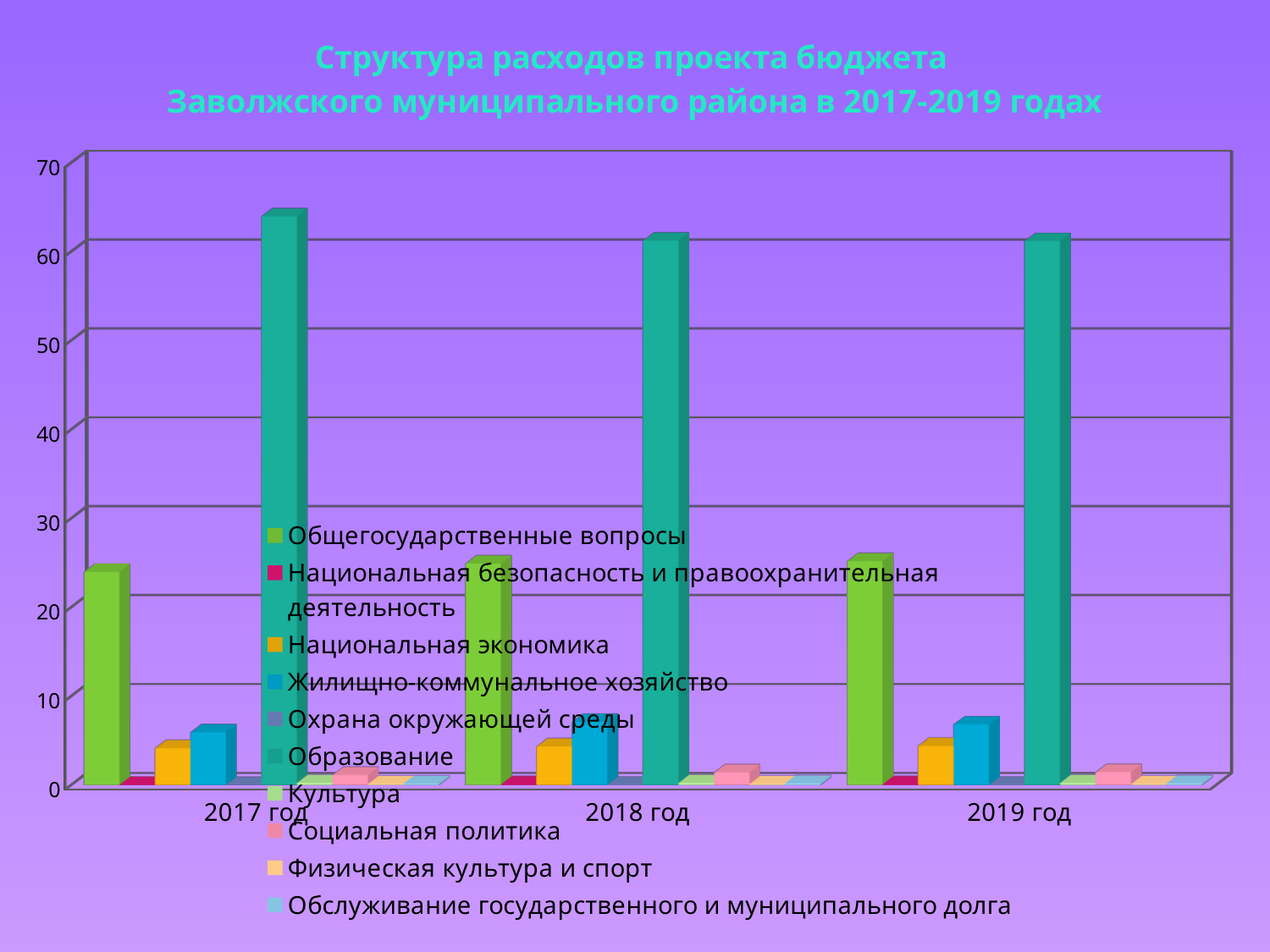
Is the value for Образование in 2017 год greater or less than 50? greater What kind of chart is shown on the slide? bar chart In 2018 год, which is larger: Образование or Общегосударственные вопросы? Образование What is the title of the chart? Структура расходов проекта бюджета Заволжского муниципального района в 2017-2019 годах Is the value for Национальная экономика in 2018 год greater or less than 10? less In 2019 год, which is larger: Жилищно-коммунальное хозяйство or Национальная экономика? Жилищно-коммунальное хозяйство Is the value for Общегосударственные вопросы in 2019 год greater or less than 30? less Which series has the highest value in 2017 год? Образование How many year categories are shown on the x axis? 3 How many series does the legend list? 10 Which series has the highest value in 2019 год? Образование